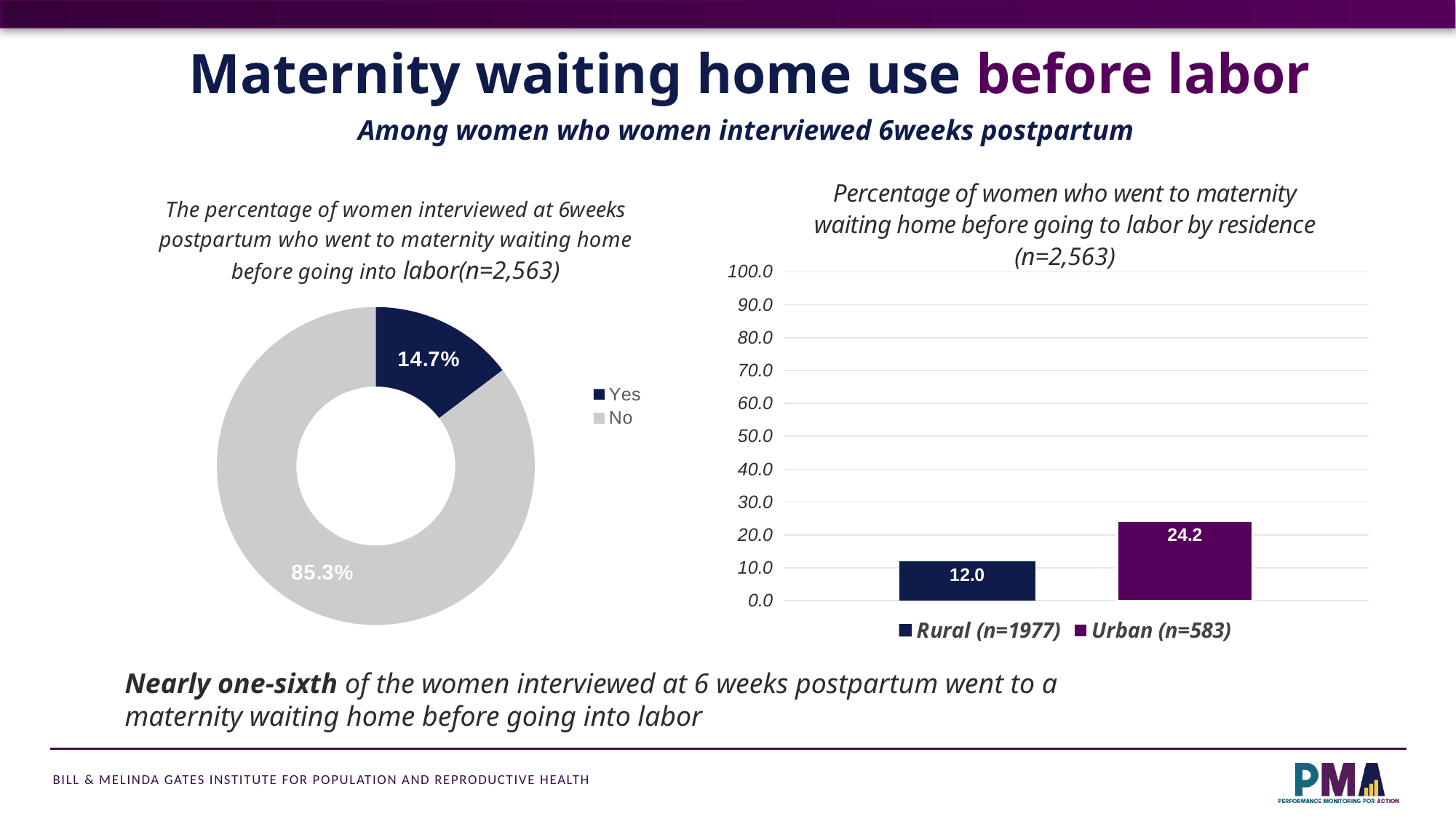
In the donut chart on the left, what percentage of women did not go to a maternity waiting home before labor (No)? 85.3% In the bar chart on the right, what is the value for Urban (n=583)? 24.2 What kind of chart is the chart on the right? Bar chart In the bar chart on the right, which residence group has the higher value? Urban (n=583) What kind of chart is the chart on the left? Donut (pie) chart In the bar chart on the right, is the value for Urban (n=583) greater or less than 20.0? greater In the donut chart on the left, what percentage of women went to a maternity waiting home before going into labor (Yes)? 14.7% In the bar chart on the right, how many bars are plotted? 2 In the bar chart on the right, what is the difference between the Urban and Rural values? 12.2 In the bar chart on the right, what is the value for Rural (n=1977)? 12.0 In the donut chart on the left, which slice is larger, Yes or No? No In the donut chart on the left, how many entries does the legend list? 2